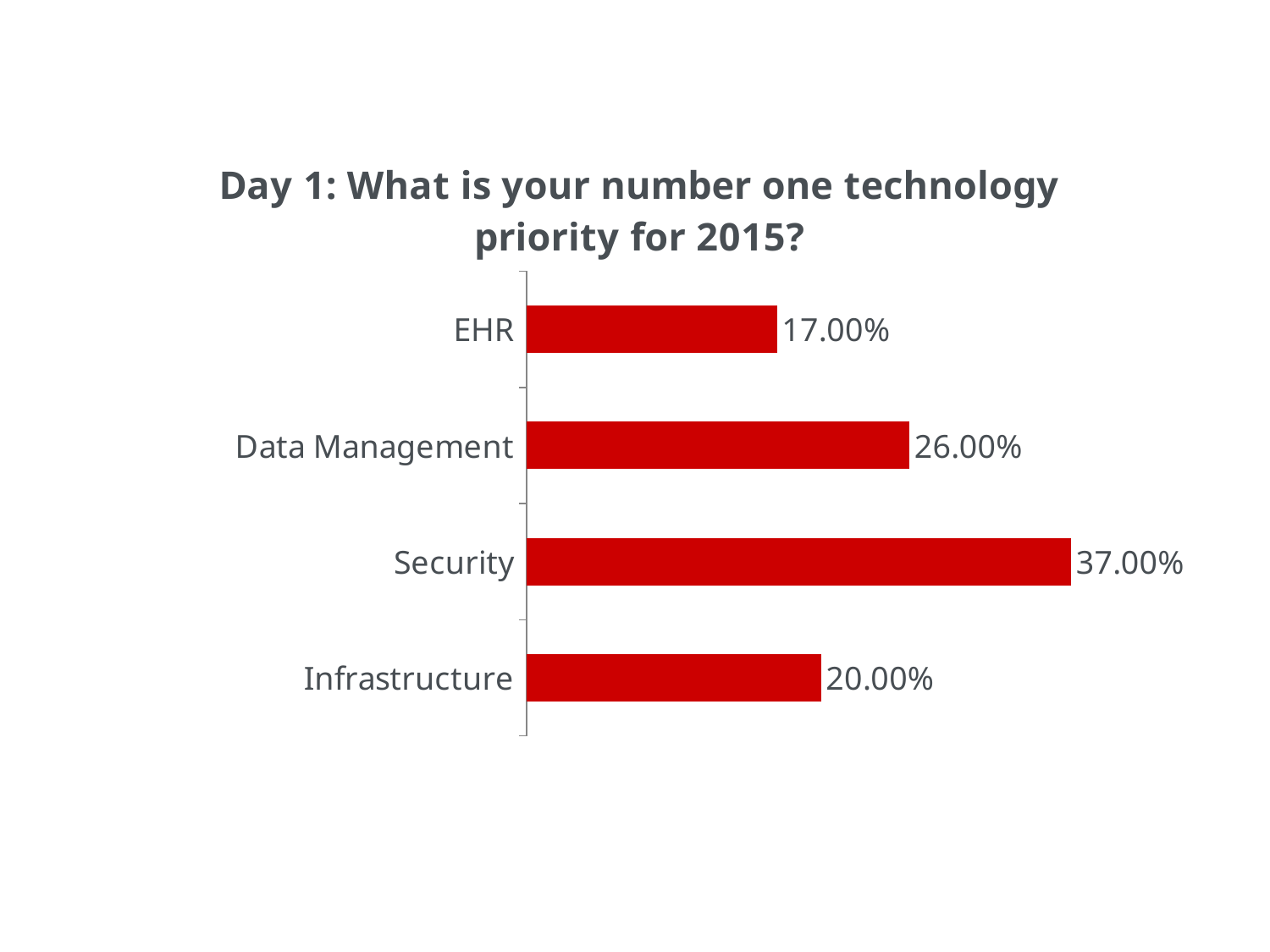
What is the value for Infrastructure? 20.00% Which is larger, the value for Data Management or the value for Infrastructure? Data Management Which category has the highest value? Security What is the difference between the values for Security and Data Management? 11.00% What kind of chart is shown on the slide? Bar chart Which category has the lowest value? EHR What is the difference between the values for Infrastructure and EHR? 3.00% What is the title of the chart? Day 1: What is your number one technology priority for 2015? What is the value for EHR? 17.00% What is the value for Data Management? 26.00% How many categories are shown in the chart? 4 What is the value for Security? 37.00%